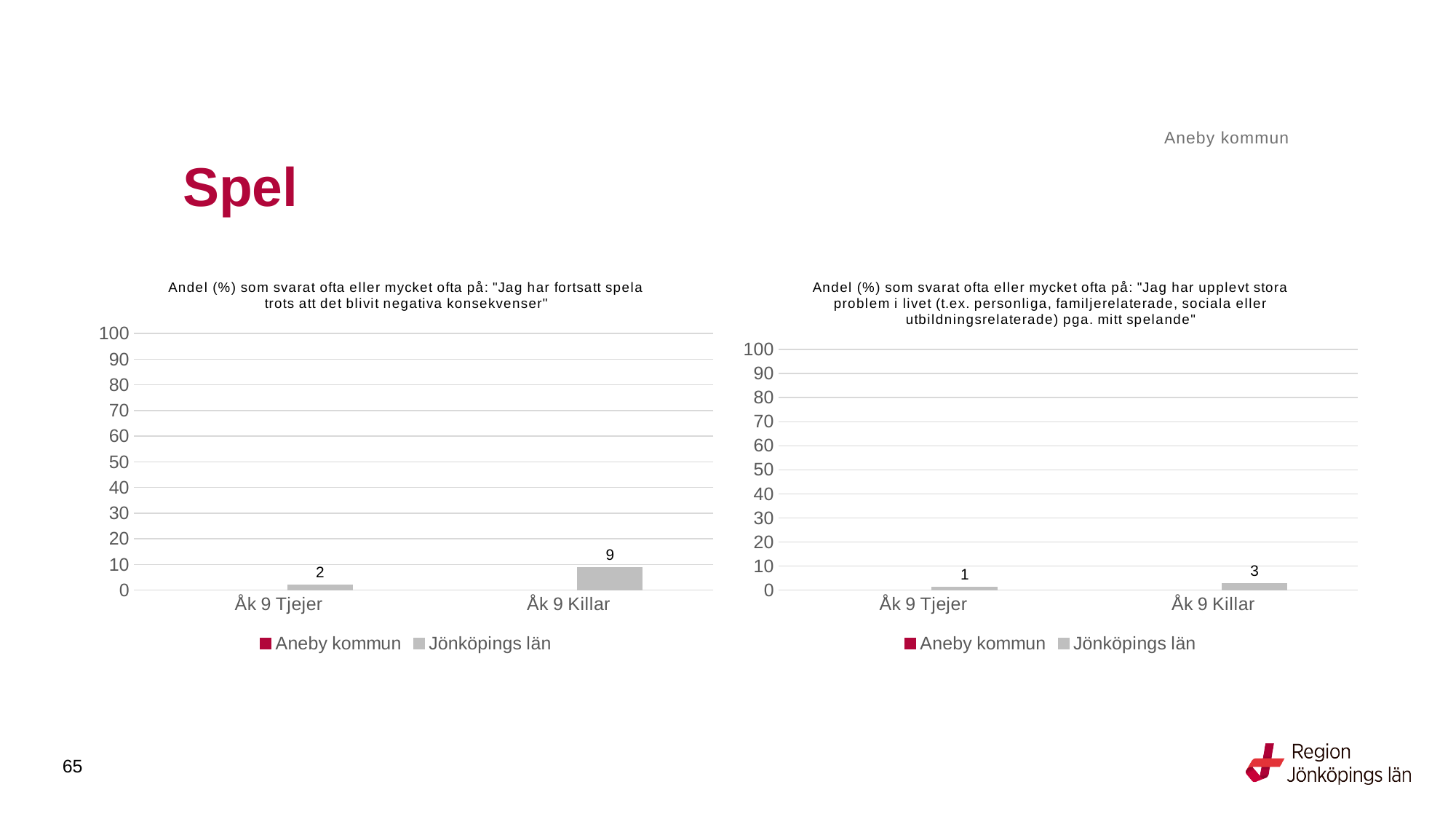
What kind of chart is the left chart? bar chart How many series does the legend of the right chart list? 2 In the right chart, what is the value for Jönköpings län for Åk 9 Killar? 3 In the left chart, is the Jönköpings län value for Åk 9 Killar greater or less than 10? less In the right chart, what is the difference between the Jönköpings län values for Åk 9 Killar and Åk 9 Tjejer? 2 In the left chart, what is the value for Jönköpings län for Åk 9 Tjejer? 2 In the right chart, what is the value for Jönköpings län for Åk 9 Tjejer? 1 In the left chart, what is the difference between the Jönköpings län values for Åk 9 Killar and Åk 9 Tjejer? 7 In the left chart, which category has the higher Jönköpings län value? Åk 9 Killar In the right chart, which category has the lower Jönköpings län value? Åk 9 Tjejer How many categories are shown on the x axis of the right chart? 2 In the left chart, what is the value for Jönköpings län for Åk 9 Killar? 9